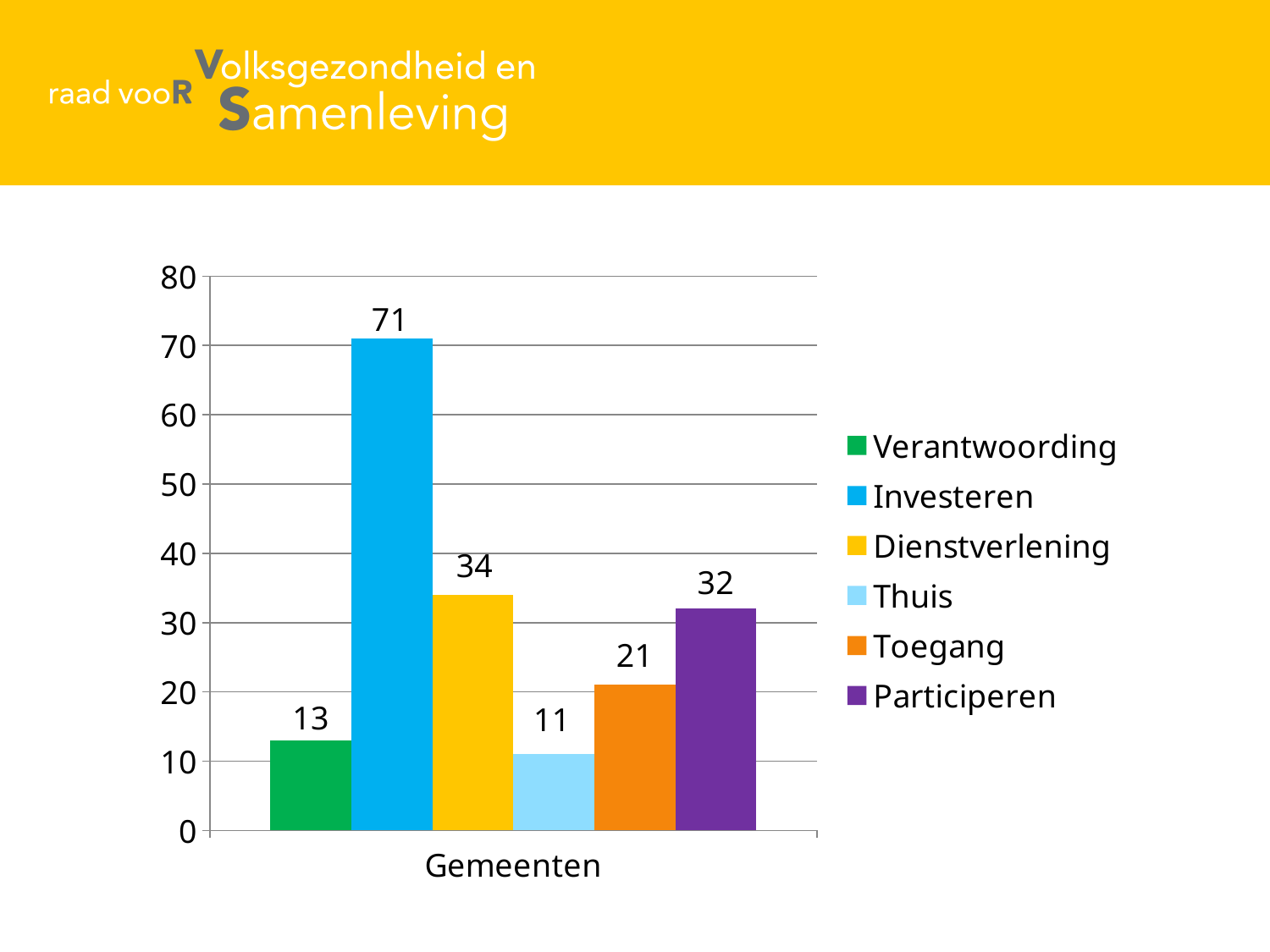
How many series does the legend list? 6 What is the label on the x axis? Gemeenten Which series has the highest value? Investeren Is the value for Dienstverlening greater or less than 30? greater What is the value for Participeren? 32 Which is larger, the value for Toegang or the value for Verantwoording? Toegang What is the value for Thuis? 11 Which series has the lowest value? Thuis What is the difference between the values for Investeren and Dienstverlening? 37 What is the value for Investeren? 71 What kind of chart is shown? bar chart What colour is the bar for Toegang? orange